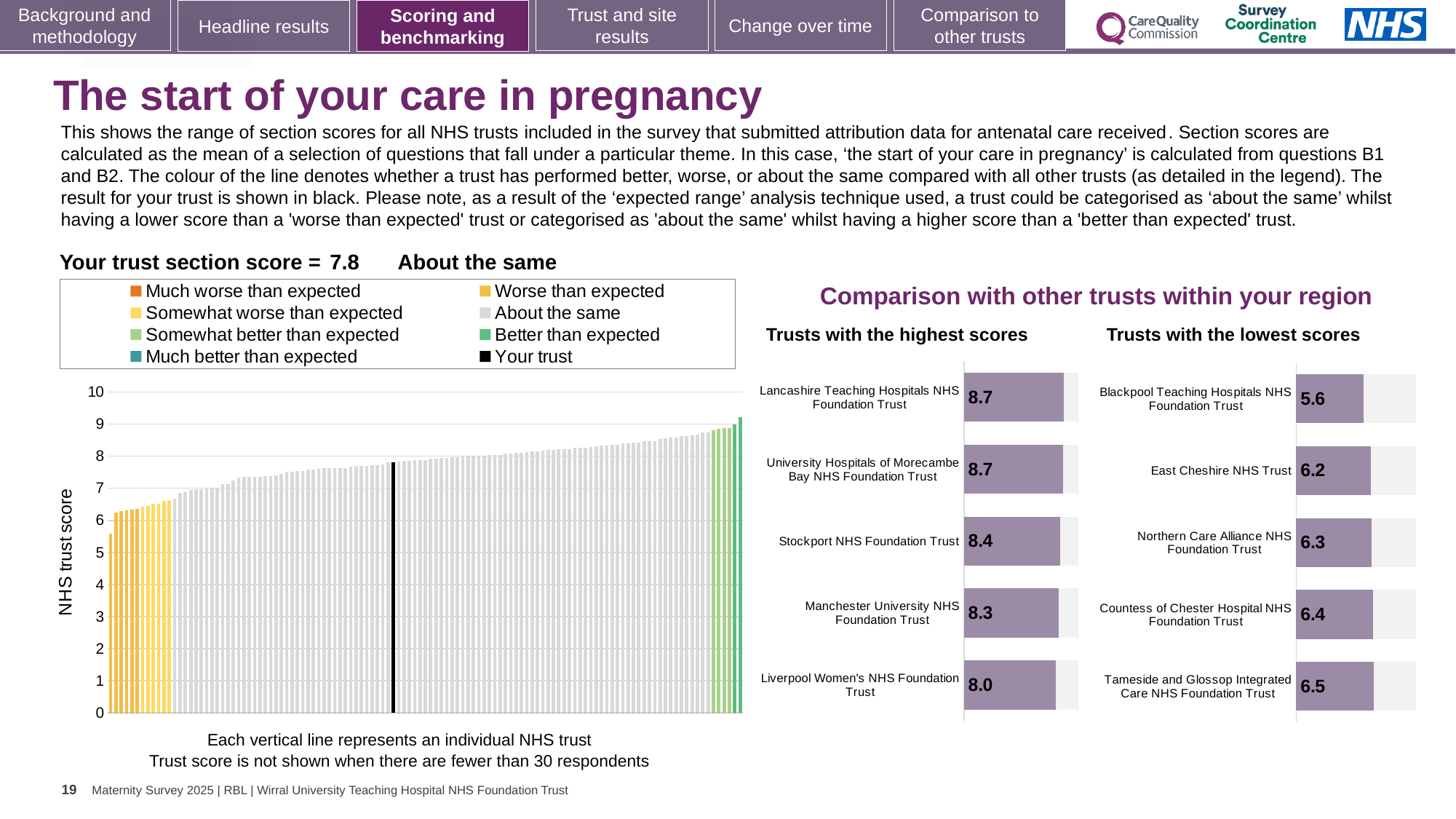
In the 'Trusts with the lowest scores' chart, which trust has the highest score? Tameside and Glossop Integrated Care NHS Foundation Trust In the 'Trusts with the lowest scores' chart, which trust has the lowest score? Blackpool Teaching Hospitals NHS Foundation Trust In the 'Trusts with the highest scores' chart, which has the higher score: Manchester University NHS Foundation Trust or Stockport NHS Foundation Trust? Stockport NHS Foundation Trust In the 'Trusts with the lowest scores' chart, what is the difference between the scores of Tameside and Glossop Integrated Care NHS Foundation Trust and Blackpool Teaching Hospitals NHS Foundation Trust? 0.9 What type of chart is the main NHS trust score chart? Bar chart In the main NHS trust score chart, is the value of the tallest bar greater or less than 9? greater What is the section score for your trust shown on the main NHS trust score chart? 7.8 In the 'Trusts with the highest scores' chart, which trust has the lowest score? Liverpool Women's NHS Foundation Trust How many trusts are shown in the 'Trusts with the lowest scores' chart? 5 In the 'Trusts with the highest scores' chart, what is the difference between the scores of Stockport NHS Foundation Trust and Liverpool Women's NHS Foundation Trust? 0.4 In the 'Trusts with the highest scores' chart, what is the score for Stockport NHS Foundation Trust? 8.4 In the 'Trusts with the lowest scores' chart, what is the score for East Cheshire NHS Trust? 6.2